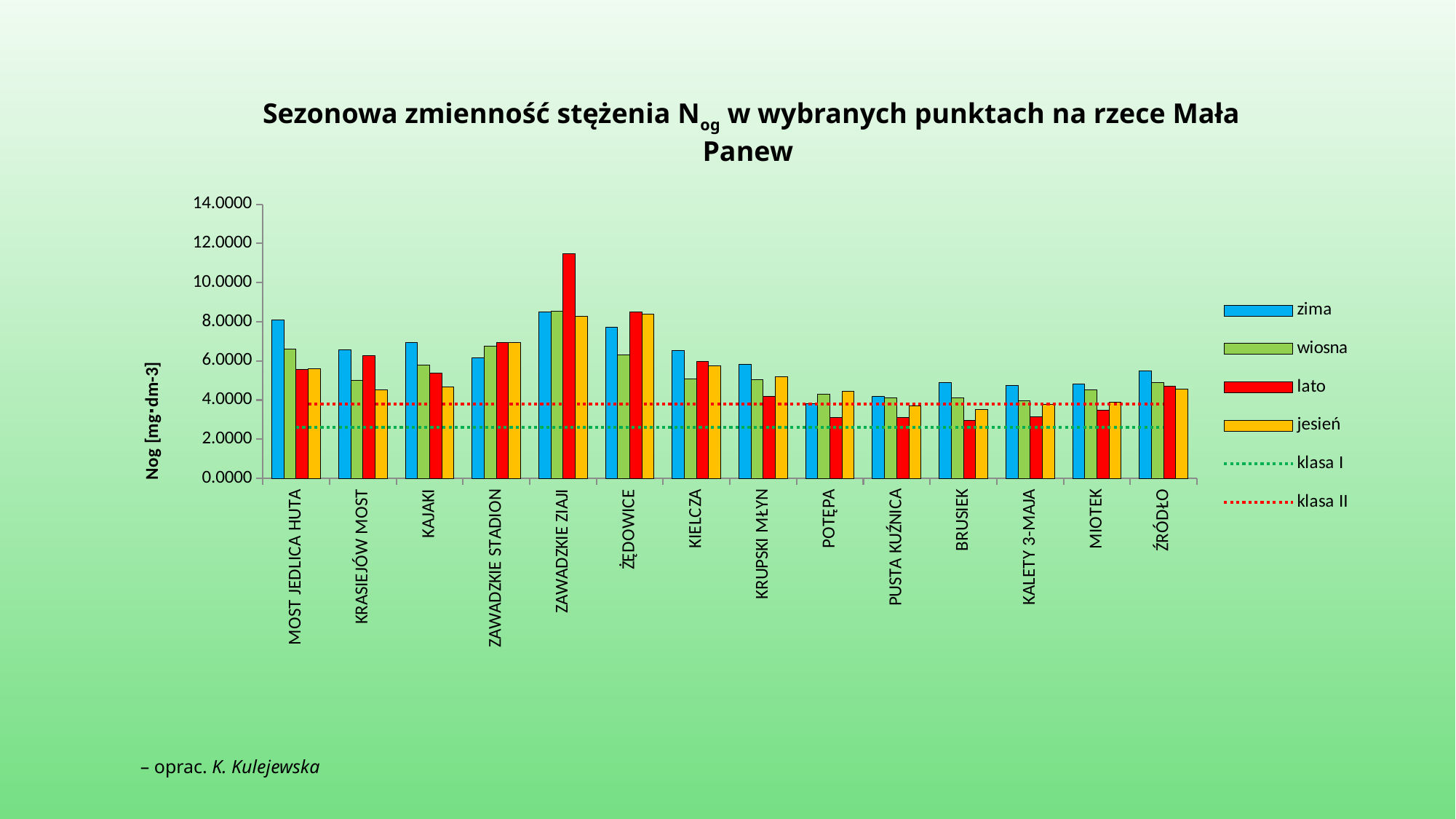
Is the lato value for ZAWADZKIE ZIAJI greater or less than 10.0000? greater Is the zima value for KIELCZA greater or less than 6.0000? greater How many entries does the legend list? 6 Is the lato value for BRUSIEK greater or less than 4.0000? less How many measurement points (categories) are shown on the x axis? 14 At which measurement point is the lato (summer) value highest? ZAWADZKIE ZIAJI At MOST JEDLICA HUTA, which is larger: the zima value or the lato value? zima At ŻĘDOWICE, which is larger: the lato value or the wiosna value? lato What kind of chart is shown on the slide? bar chart Which legend entry is drawn as a green dotted line? klasa I What is the label of the y axis? Nog [mg·dm-3]